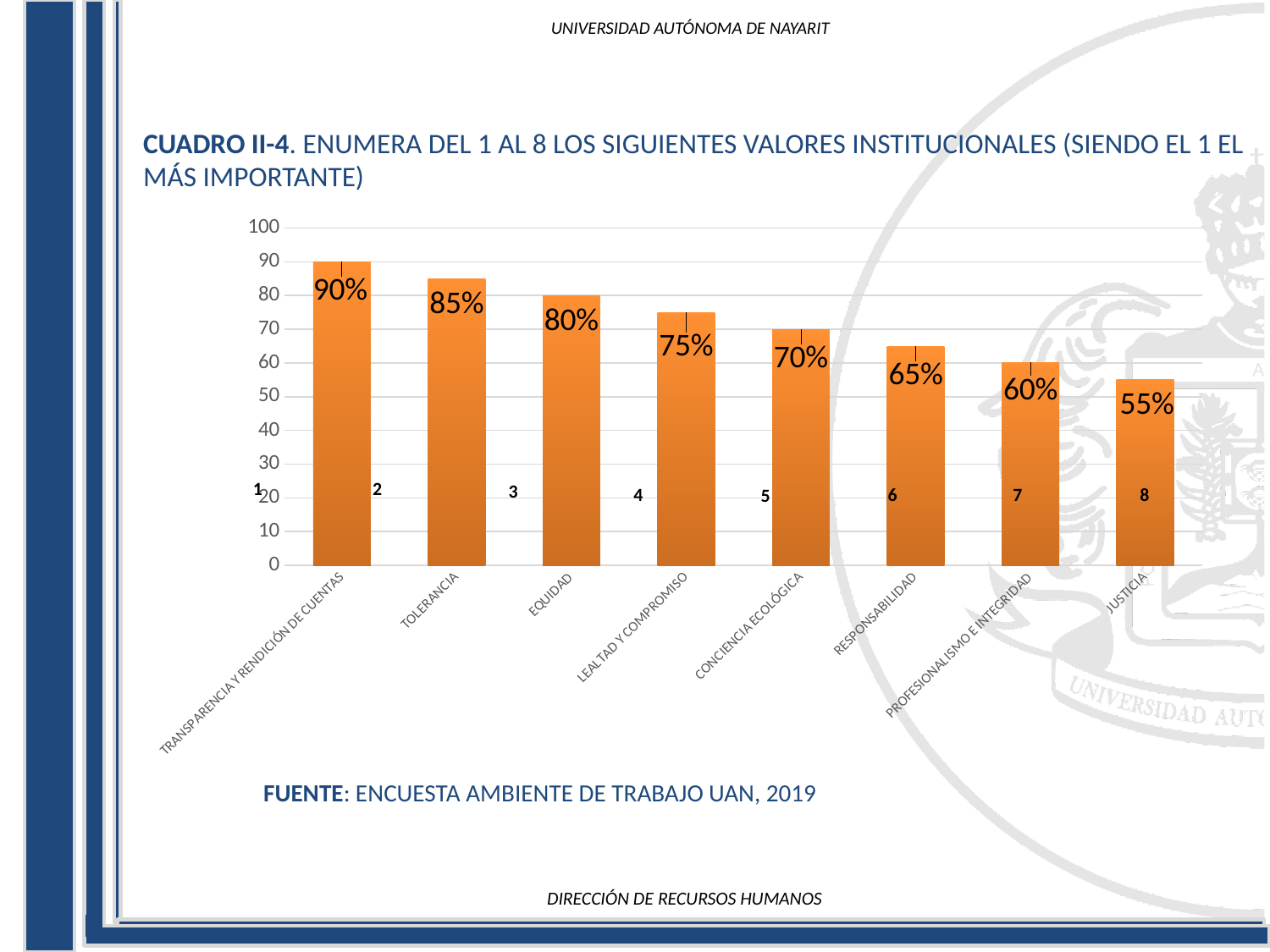
What kind of chart is shown on the slide? Bar chart What is the difference between the values for EQUIDAD and RESPONSABILIDAD? 15% What is the value for JUSTICIA? 55% Which category has the lowest value? JUSTICIA Do the values rise or fall from left to right along the x axis? Fall Is the value for RESPONSABILIDAD greater or less than 60? greater Which category has the highest value? TRANSPARENCIA Y RENDICIÓN DE CUENTAS What source is cited below the chart? ENCUESTA AMBIENTE DE TRABAJO UAN, 2019 How many categories are shown in the chart? 8 Which is larger, the value for LEALTAD Y COMPROMISO or the value for PROFESIONALISMO E INTEGRIDAD? LEALTAD Y COMPROMISO What is the value for CONCIENCIA ECOLÓGICA? 70% What is the value for TOLERANCIA? 85%